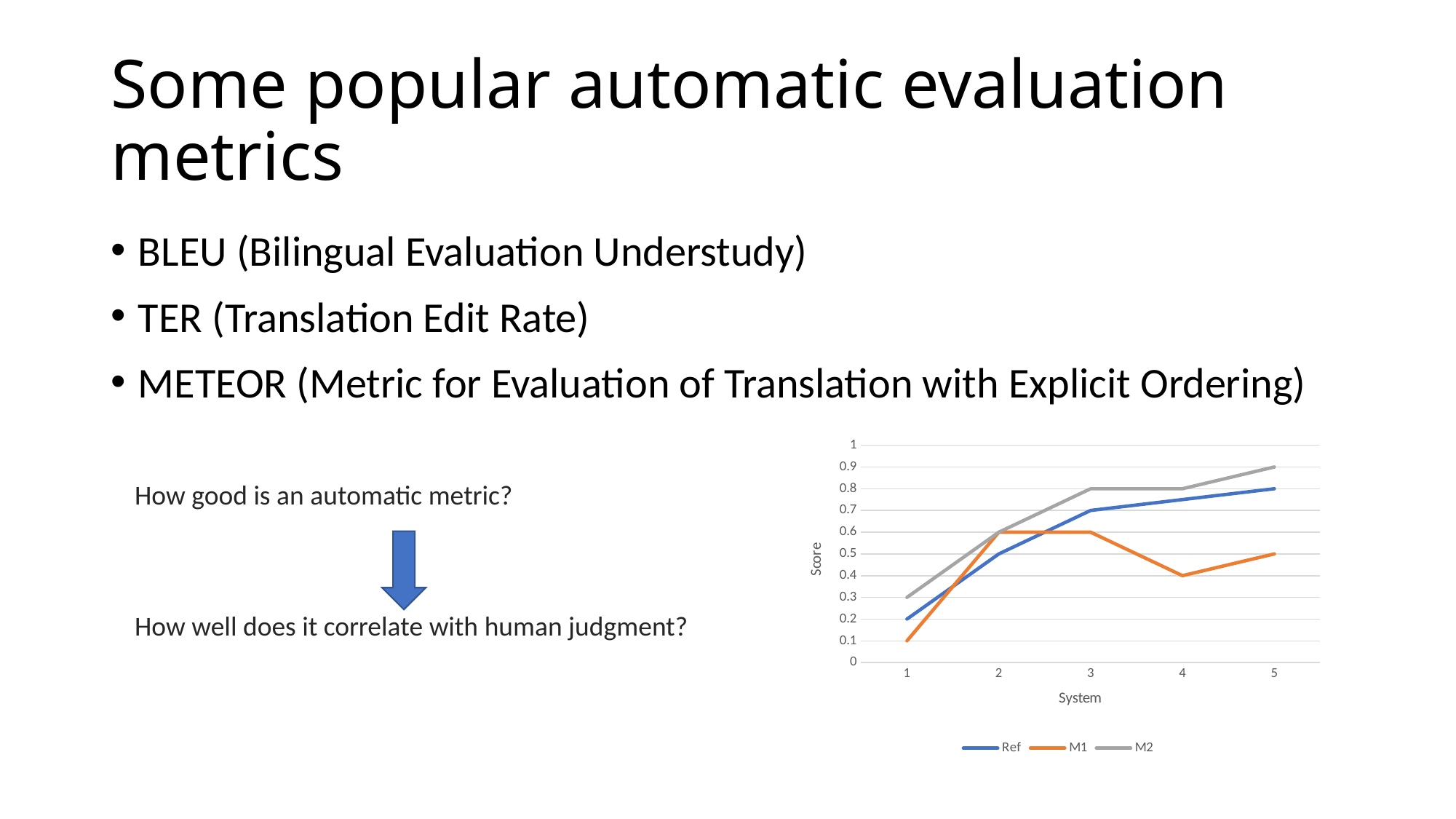
What is the M2 score for system 5? 0.9 For which system is the M1 score lowest? 1 Does the M2 score rise or fall from system 1 to system 5? rise What is the difference between the M2 and M1 scores at system 5? 0.4 How many systems are plotted along the x axis of the chart? 5 What kind of chart is shown on the slide? line chart What is the Ref score for system 1? 0.2 For which system is the M2 score highest? 5 What is the label on the chart's y axis? Score At system 4, which series has the larger score, M1 or M2? M2 How many series does the chart's legend list? 3 What is the M1 score for system 4? 0.4